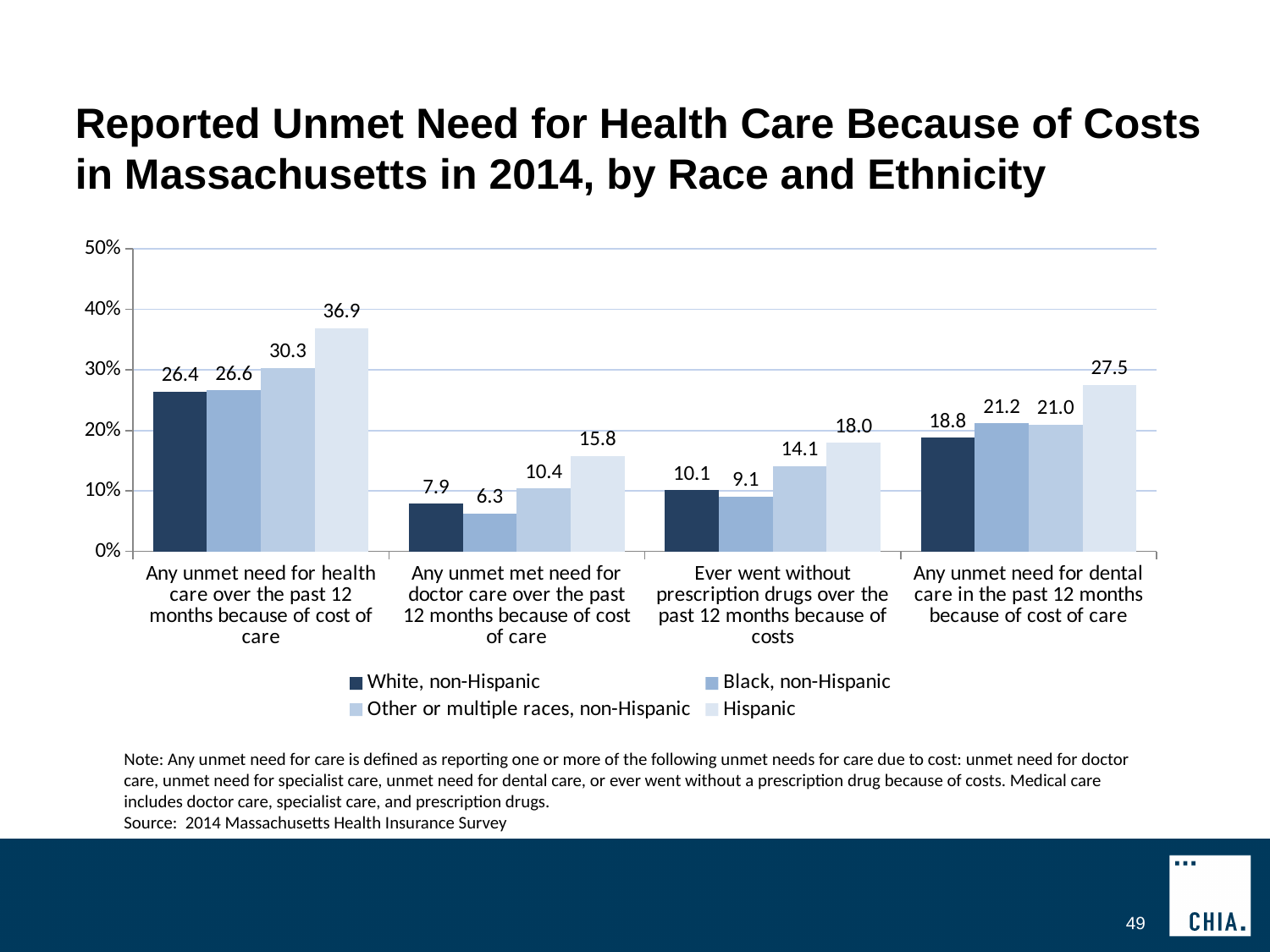
Is the Hispanic value for 'Any unmet need for dental care in the past 12 months because of cost of care' greater or less than 30%? less What is the value for White, non-Hispanic in the 'Ever went without prescription drugs over the past 12 months because of costs' category? 10.1 What is the value for Hispanic in the 'Any unmet need for health care over the past 12 months because of cost of care' category? 36.9 Which series has the lowest value in the 'Ever went without prescription drugs over the past 12 months because of costs' category? Black, non-Hispanic What is the difference between the Hispanic and White, non-Hispanic values in the 'Any unmet need for health care over the past 12 months because of cost of care' category? 10.5 What kind of chart is shown on the slide? Bar chart Which is larger: the Other or multiple races, non-Hispanic value for doctor care or for prescription drugs? Prescription drugs (14.1) What is the value for Black, non-Hispanic in the 'Any unmet met need for doctor care over the past 12 months because of cost of care' category? 6.3 What is the source cited for the chart? 2014 Massachusetts Health Insurance Survey How many categories are shown on the x axis? 4 Which series has the highest value in the 'Any unmet need for dental care in the past 12 months because of cost of care' category? Hispanic How many series does the legend list? 4